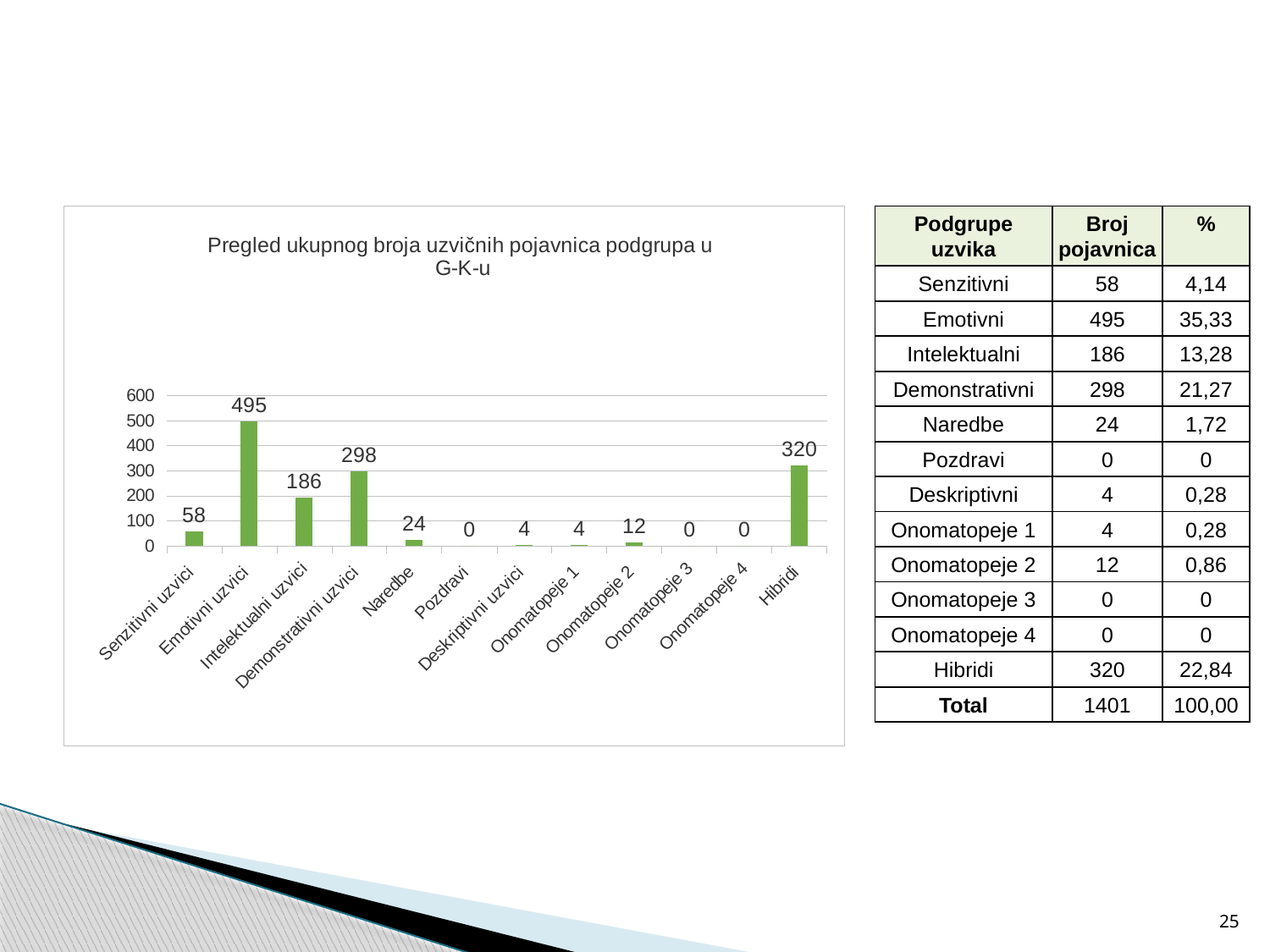
How many categories are shown on the x axis of the chart? 12 What is the title of the chart? Pregled ukupnog broja uzvičnih pojavnica podgrupa u G-K-u What is the value for Emotivni uzvici? 495 What is the difference between the values for Intelektualni uzvici and Senzitivni uzvici? 128 How many categories in the chart have a value of 0? 3 What is the value for Naredbe? 24 What is the value for Demonstrativni uzvici? 298 Which is larger, the value for Hibridi or the value for Demonstrativni uzvici? Hibridi What kind of chart is shown on the slide? Bar chart What is the difference between the values for Hibridi and Demonstrativni uzvici? 22 Which category has the highest value? Emotivni uzvici What is the value for Hibridi? 320